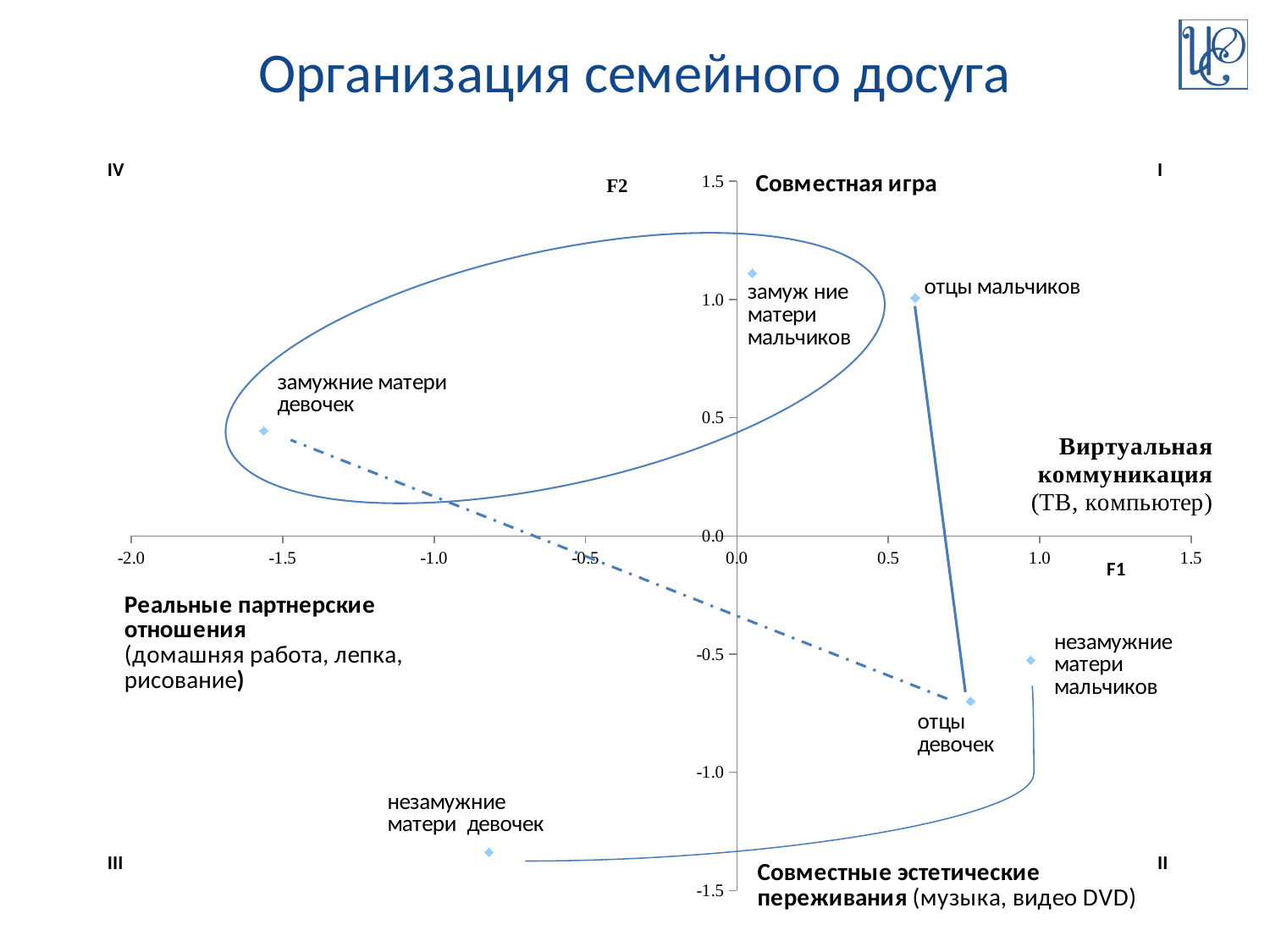
Which group has the lowest F1 value on the chart? замужние матери девочек Is the F2 value for 'отцы мальчиков' greater or less than 0.5? greater Which group has the lowest F2 value on the chart? незамужние матери девочек Is the F1 value for 'замужние матери девочек' greater or less than -1.0? less Is the F1 value for 'незамужние матери мальчиков' greater or less than 0.5? greater What kind of chart is shown on the slide? scatter plot Which has the higher F2 value: 'отцы девочек' or 'замужние матери девочек'? замужние матери девочек How many data points are plotted on the chart? 6 What is the title of the slide containing the chart? Организация семейного досуга What are the labels of the horizontal and vertical axes of the chart? F1 and F2 Which group has the highest F1 value on the chart? незамужние матери мальчиков